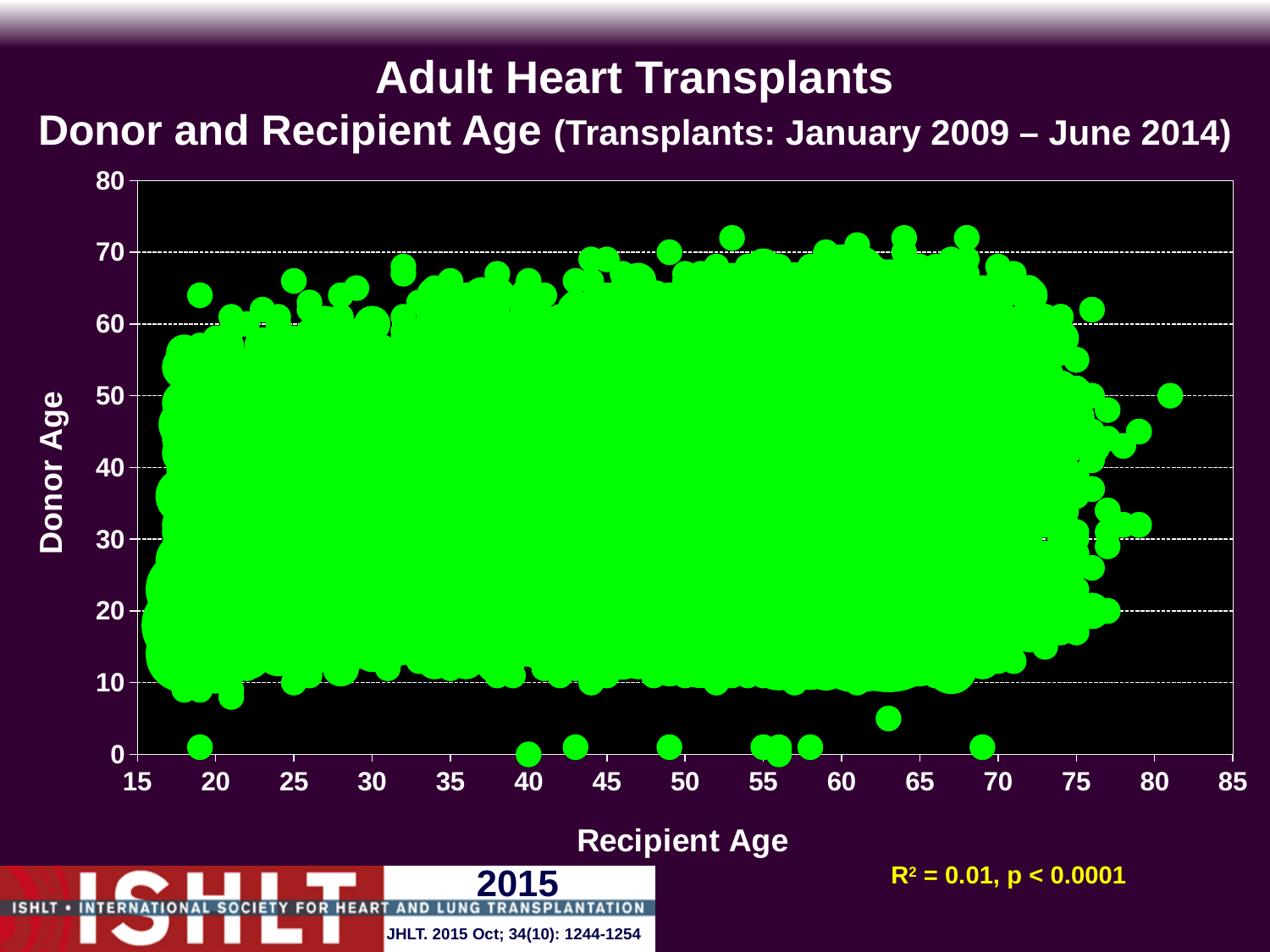
What kind of chart is shown on the slide? scatter plot Is the highest donor age plotted on the chart greater or less than 80? less What R-squared value is reported for the relationship between donor and recipient age? R2 = 0.01 Is the highest recipient age plotted on the chart greater or less than 85? less Is the highest recipient age plotted on the chart greater or less than 80? greater What variable is plotted on the x axis of the chart? Recipient Age